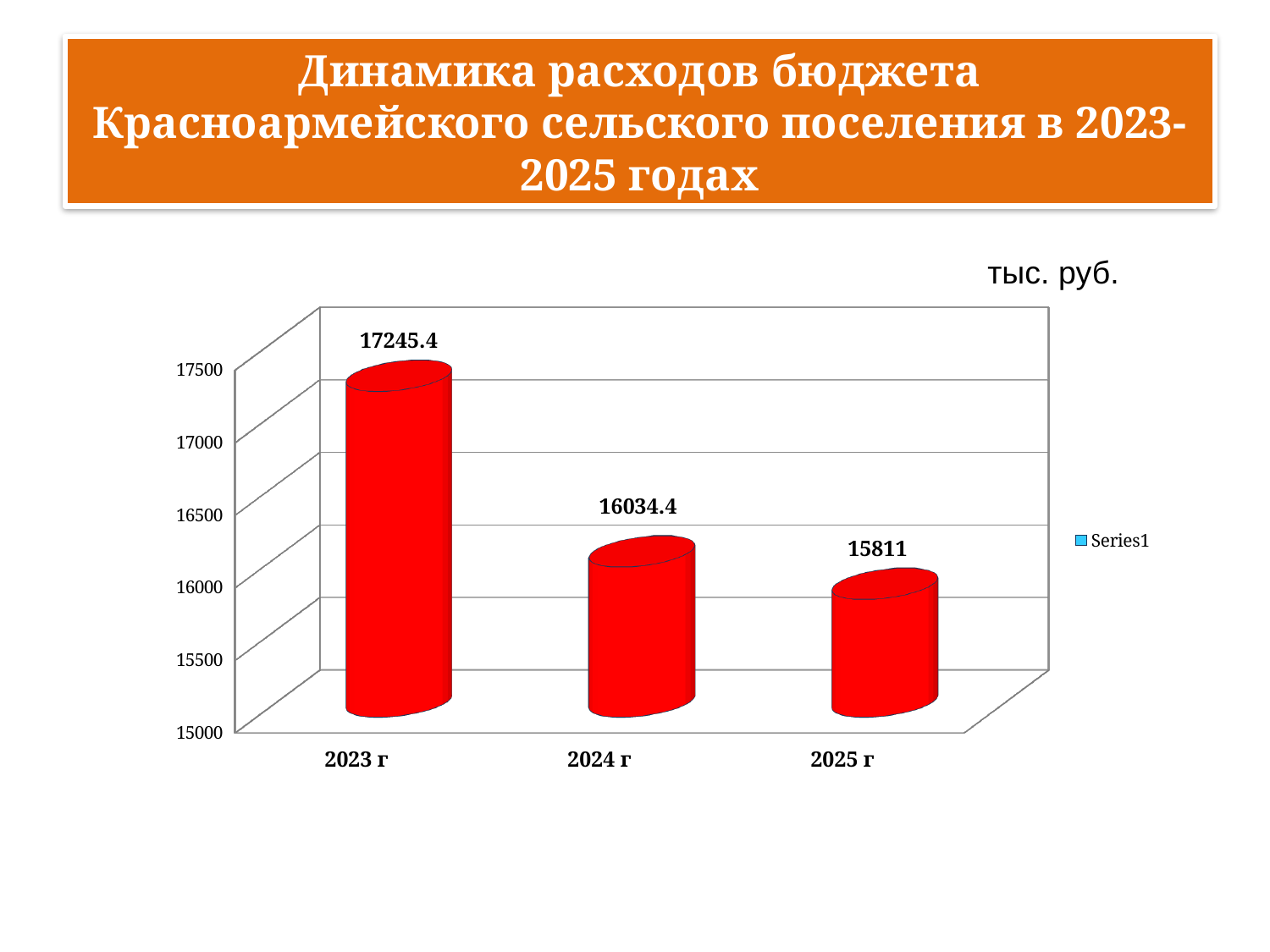
What is the value for 2024 г? 16034.4 What is the value for 2023 г? 17245.4 Do the values rise or fall from 2023 г to 2025 г? fall Which is larger, the value for 2024 г or the value for 2025 г? 2024 г What is the difference between the values for 2024 г and 2025 г? 223.4 What is the value for 2025 г? 15811 What is the difference between the values for 2023 г and 2024 г? 1211 How many years are shown on the chart? 3 Which year has the lowest value? 2025 г What kind of chart is shown on the slide? bar chart Which year has the highest value? 2023 г How many series does the legend list? 1